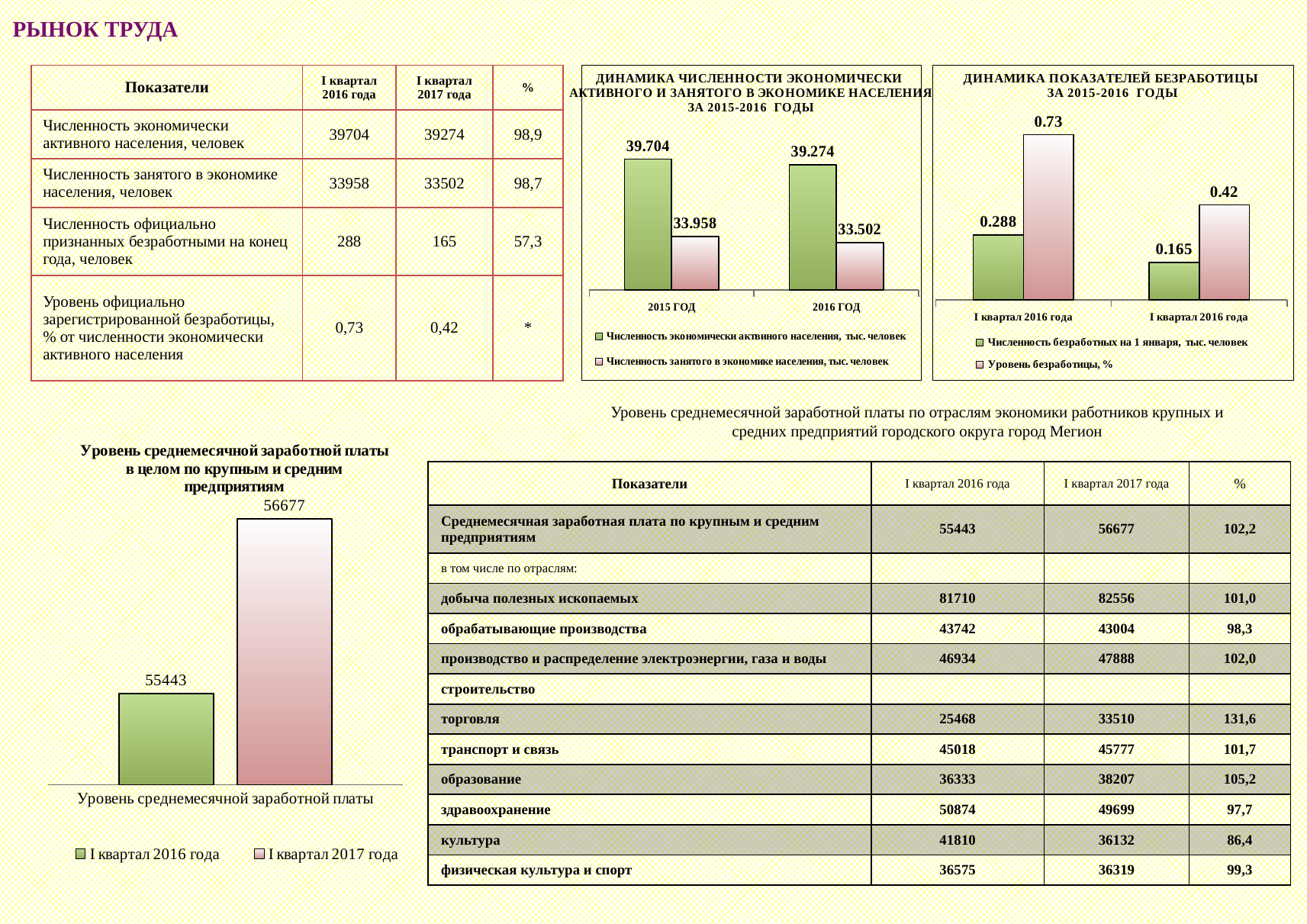
In the chart titled 'ДИНАМИКА ЧИСЛЕННОСТИ ЭКОНОМИЧЕСКИ АКТИВНОГО И ЗАНЯТОГО В ЭКОНОМИКЕ НАСЕЛЕНИЯ ЗА 2015-2016 ГОДЫ', how many series does the legend list? 2 In the chart titled 'ДИНАМИКА ЧИСЛЕННОСТИ ЭКОНОМИЧЕСКИ АКТИВНОГО И ЗАНЯТОГО В ЭКОНОМИКЕ НАСЕЛЕНИЯ ЗА 2015-2016 ГОДЫ', does 'Численность экономически активного населения' rise or fall from 2015 ГОД to 2016 ГОД? fall In the chart titled 'ДИНАМИКА ПОКАЗАТЕЛЕЙ БЕЗРАБОТИЦЫ ЗА 2015-2016 ГОДЫ', what is the highest value shown for 'Уровень безработицы, %'? 0.73 In the chart titled 'Уровень среднемесячной заработной платы в целом по крупным и средним предприятиям', what is the difference between the 'I квартал 2017 года' and 'I квартал 2016 года' values? 1234 What kind of chart is the one titled 'ДИНАМИКА ПОКАЗАТЕЛЕЙ БЕЗРАБОТИЦЫ ЗА 2015-2016 ГОДЫ'? bar chart In the chart titled 'ДИНАМИКА ПОКАЗАТЕЛЕЙ БЕЗРАБОТИЦЫ ЗА 2015-2016 ГОДЫ', what is the lowest value shown for 'Численность безработных на 1 января, тыс. человек'? 0.165 In the chart titled 'ДИНАМИКА ПОКАЗАТЕЛЕЙ БЕЗРАБОТИЦЫ ЗА 2015-2016 ГОДЫ', what is the difference between the two 'Уровень безработицы, %' values? 0.31 In the chart titled 'Уровень среднемесячной заработной платы в целом по крупным и средним предприятиям', which series has the larger value, 'I квартал 2016 года' or 'I квартал 2017 года'? I квартал 2017 года In the chart titled 'ДИНАМИКА ЧИСЛЕННОСТИ ЭКОНОМИЧЕСКИ АКТИВНОГО И ЗАНЯТОГО В ЭКОНОМИКЕ НАСЕЛЕНИЯ ЗА 2015-2016 ГОДЫ', what is the difference between the two values shown for 2015 ГОД? 5.746 In the chart titled 'ДИНАМИКА ЧИСЛЕННОСТИ ЭКОНОМИЧЕСКИ АКТИВНОГО И ЗАНЯТОГО В ЭКОНОМИКЕ НАСЕЛЕНИЯ ЗА 2015-2016 ГОДЫ', what is the value of 'Численность занятого в экономике населения, тыс. человек' for 2016 ГОД? 33.502 In the chart titled 'Уровень среднемесячной заработной платы в целом по крупным и средним предприятиям', what is the value for 'I квартал 2017 года'? 56677 In the chart titled 'ДИНАМИКА ЧИСЛЕННОСТИ ЭКОНОМИЧЕСКИ АКТИВНОГО И ЗАНЯТОГО В ЭКОНОМИКЕ НАСЕЛЕНИЯ ЗА 2015-2016 ГОДЫ', what is the value of 'Численность экономически активного населения, тыс. человек' for 2015 ГОД? 39.704